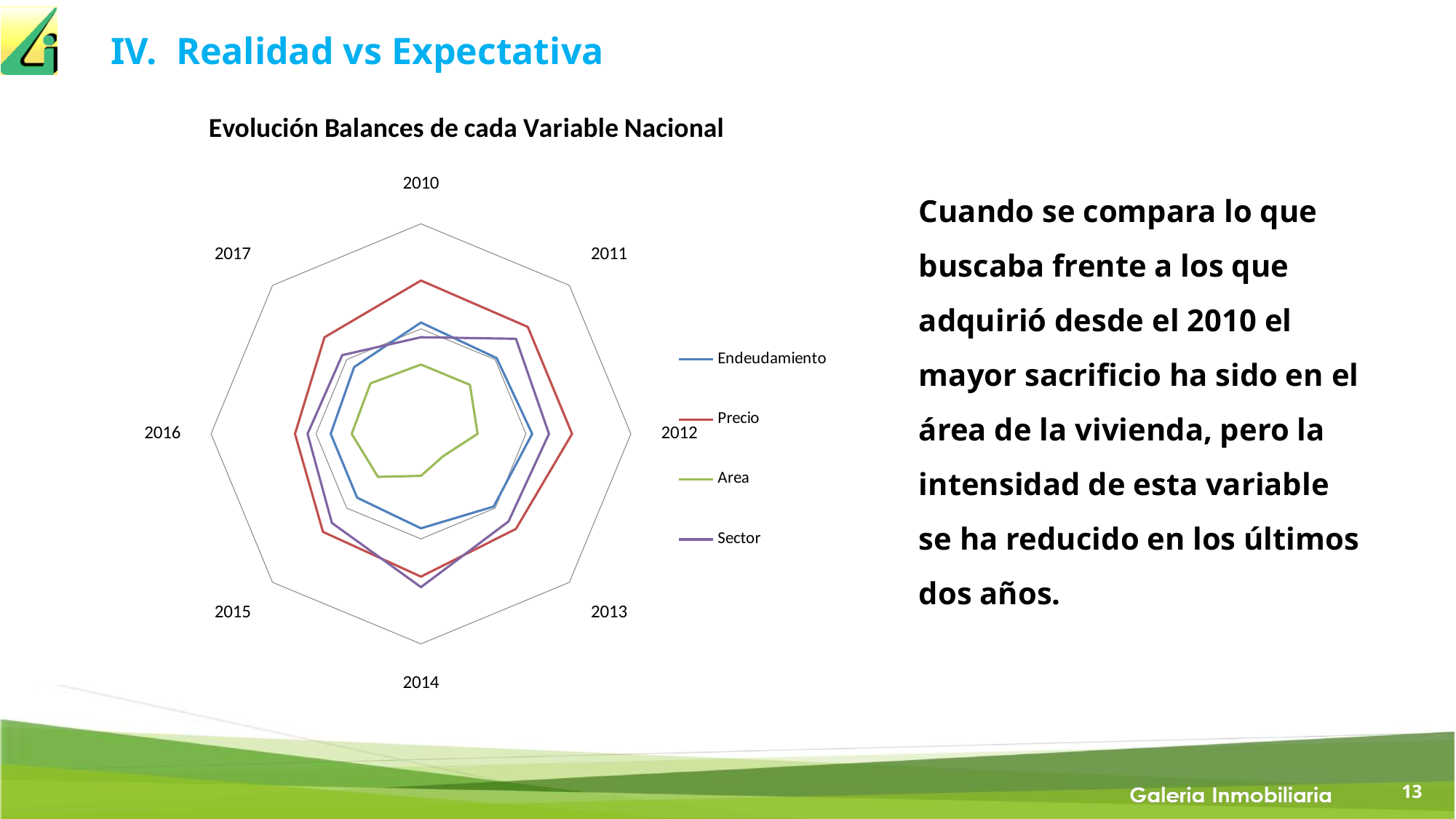
Which series has the lowest value for 2010? Area For 2012, which series has the larger value, Precio or Area? Precio For 2017, which series has the larger value, Precio or Endeudamiento? Precio For 2010, which series has the larger value, Endeudamiento or Area? Endeudamiento Which series has the highest value for 2010? Precio Which series has the highest value for 2011? Precio What is the title of the chart? Evolución Balances de cada Variable Nacional Which series is drawn in green in the chart? Area Which series has the lowest value for 2014? Area How many series does the chart's legend list? 4 What kind of chart is shown on the slide? Radar chart How many years (categories) are plotted around the radar chart? 8